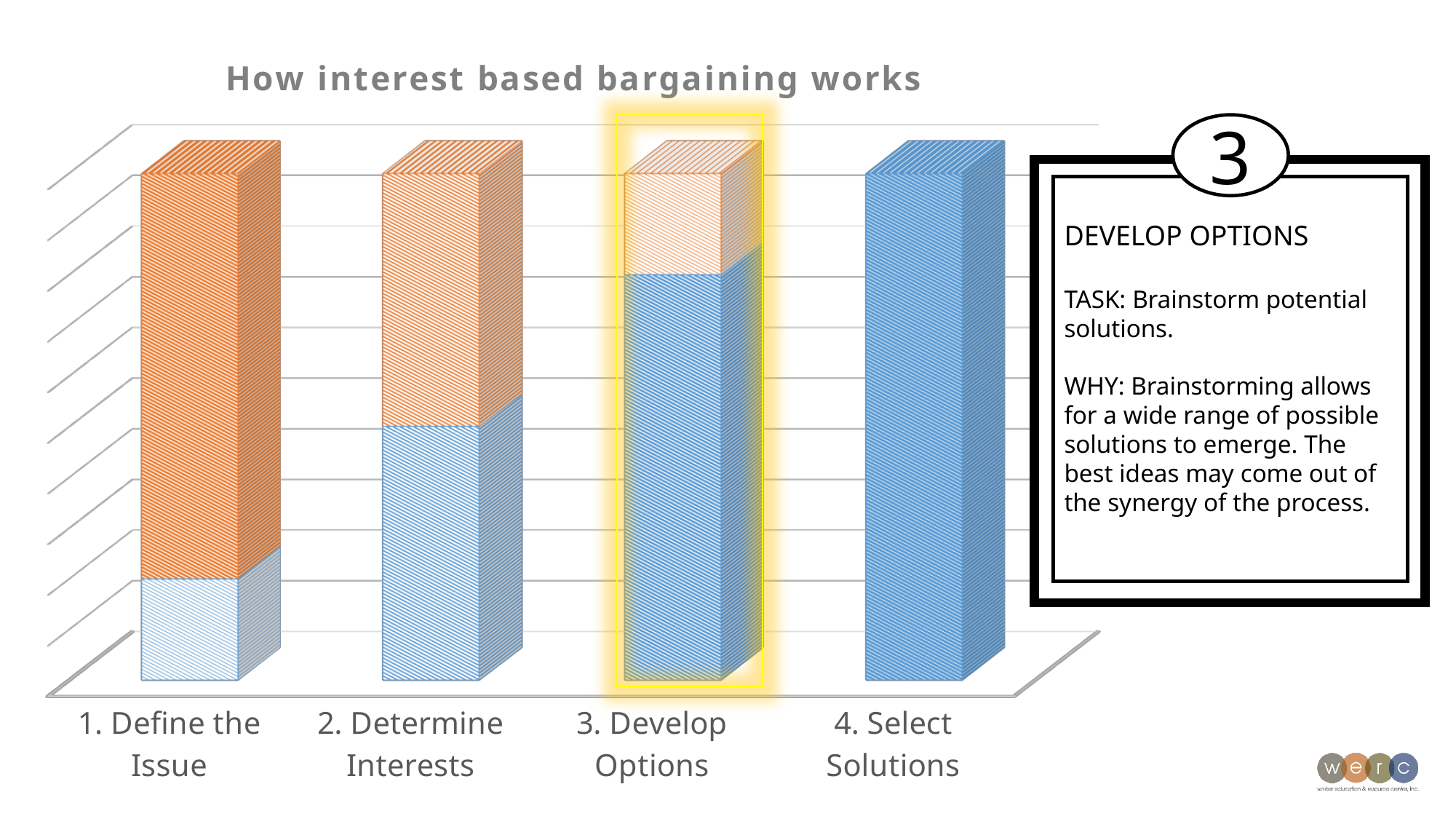
Which category's bar contains no orange segment at all? 4. Select Solutions How many categories are shown along the x axis of the chart? 4 Which category has the largest blue segment? 4. Select Solutions Does the orange segment rise or fall moving from left to right along the x axis? Fall Which category has the largest orange segment? 1. Define the Issue Which category has the smallest blue segment? 1. Define the Issue Which has the larger blue segment, 1. Define the Issue or 3. Develop Options? 3. Develop Options Does the blue segment rise or fall moving from left to right along the x axis? Rise Which category's bar is highlighted with a yellow outline on the slide? 3. Develop Options What is the title of the chart? How interest based bargaining works Which has the larger orange segment, 2. Determine Interests or 3. Develop Options? 2. Determine Interests What kind of chart is shown on the slide? Stacked bar chart